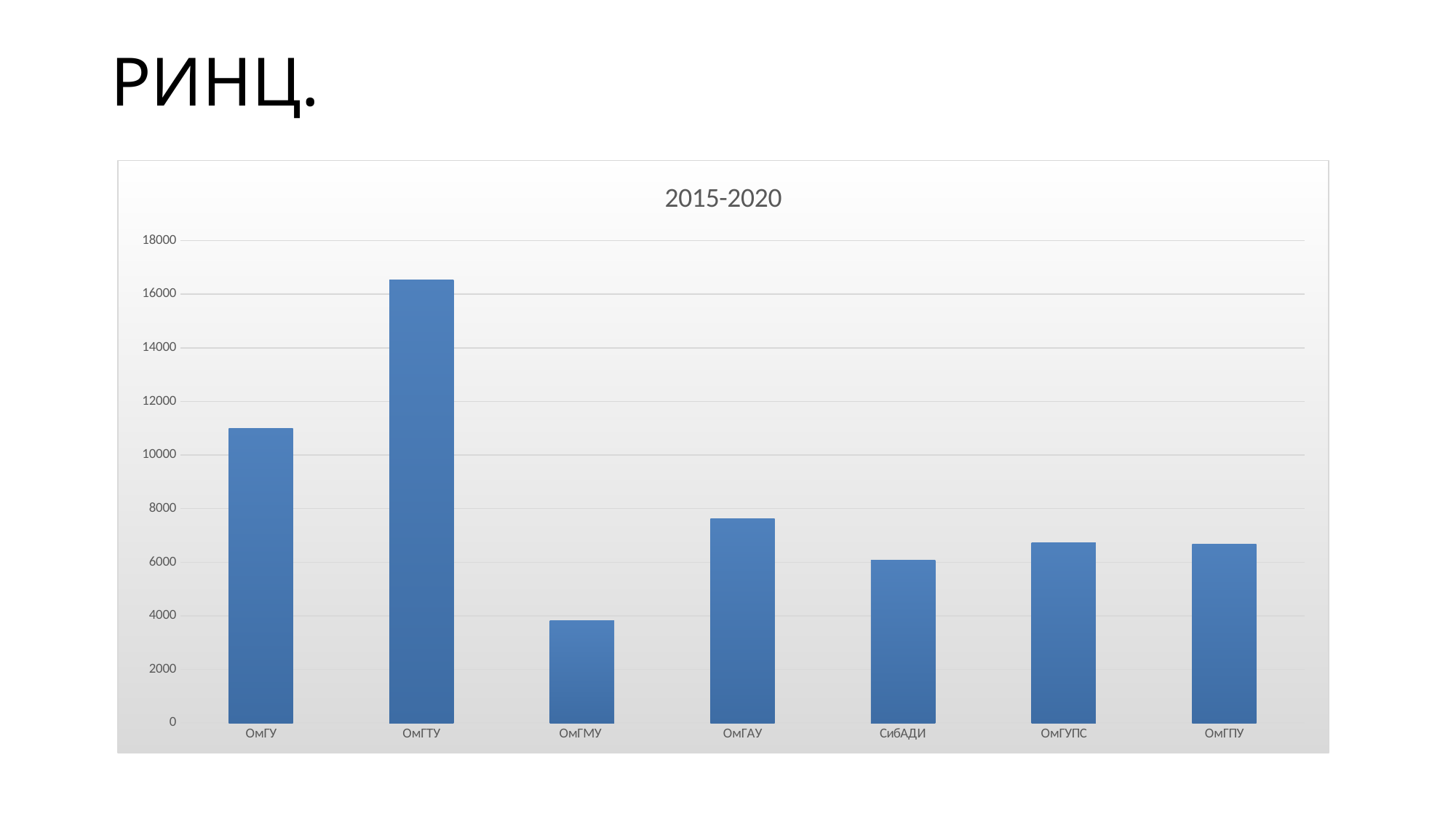
Which is larger, the value for ОмГМУ or the value for ОмГПУ? ОмГПУ Is the value for ОмГУ greater or less than 10000? greater What kind of chart is shown on the slide? bar chart Is the value for ОмГАУ greater or less than 8000? less Which is larger, the value for ОмГУ or the value for ОмГАУ? ОмГУ Is the value for СибАДИ greater or less than 4000? greater What is the title of the chart? 2015-2020 Which category has the highest value in the chart? ОмГТУ Which category has the lowest value in the chart? ОмГМУ How many categories are shown on the x axis of the chart? 7